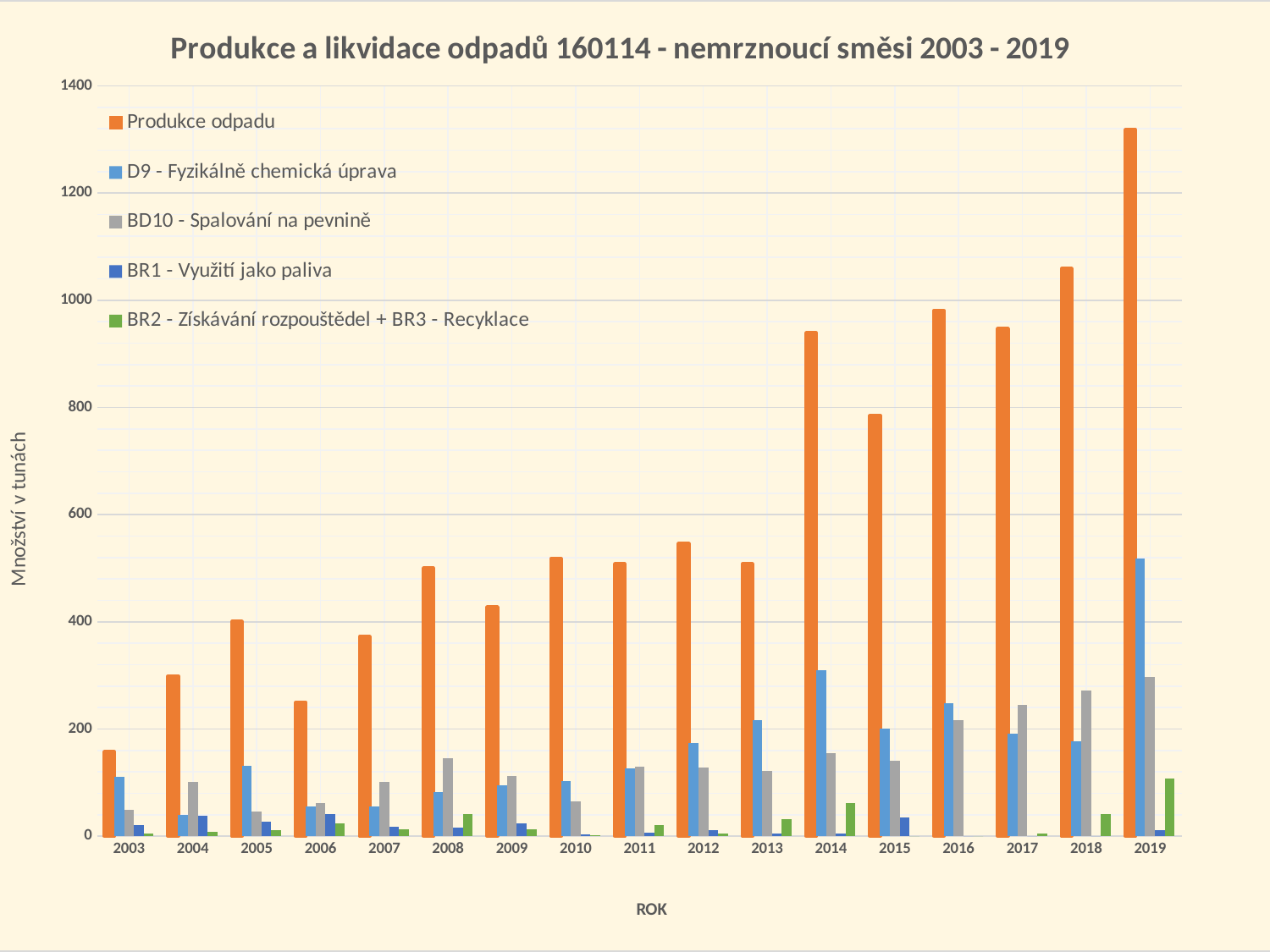
In which year is Produkce odpadu lowest? 2003 Does Produkce odpadu generally rise or fall from 2003 to 2019? rise How many series does the legend list? 5 What is the label of the y axis? Množství v tunách Is the value for D9 - Fyzikálně chemická úprava in 2019 greater or less than 400? greater Is the value for Produkce odpadu in 2019 greater or less than 1200? greater In which year is Produkce odpadu highest? 2019 Is the value for Produkce odpadu in 2003 greater or less than 200? less Which is larger, Produkce odpadu in 2014 or in 2013? 2014 How many years are shown on the x axis? 17 What kind of chart is shown on the slide? bar chart